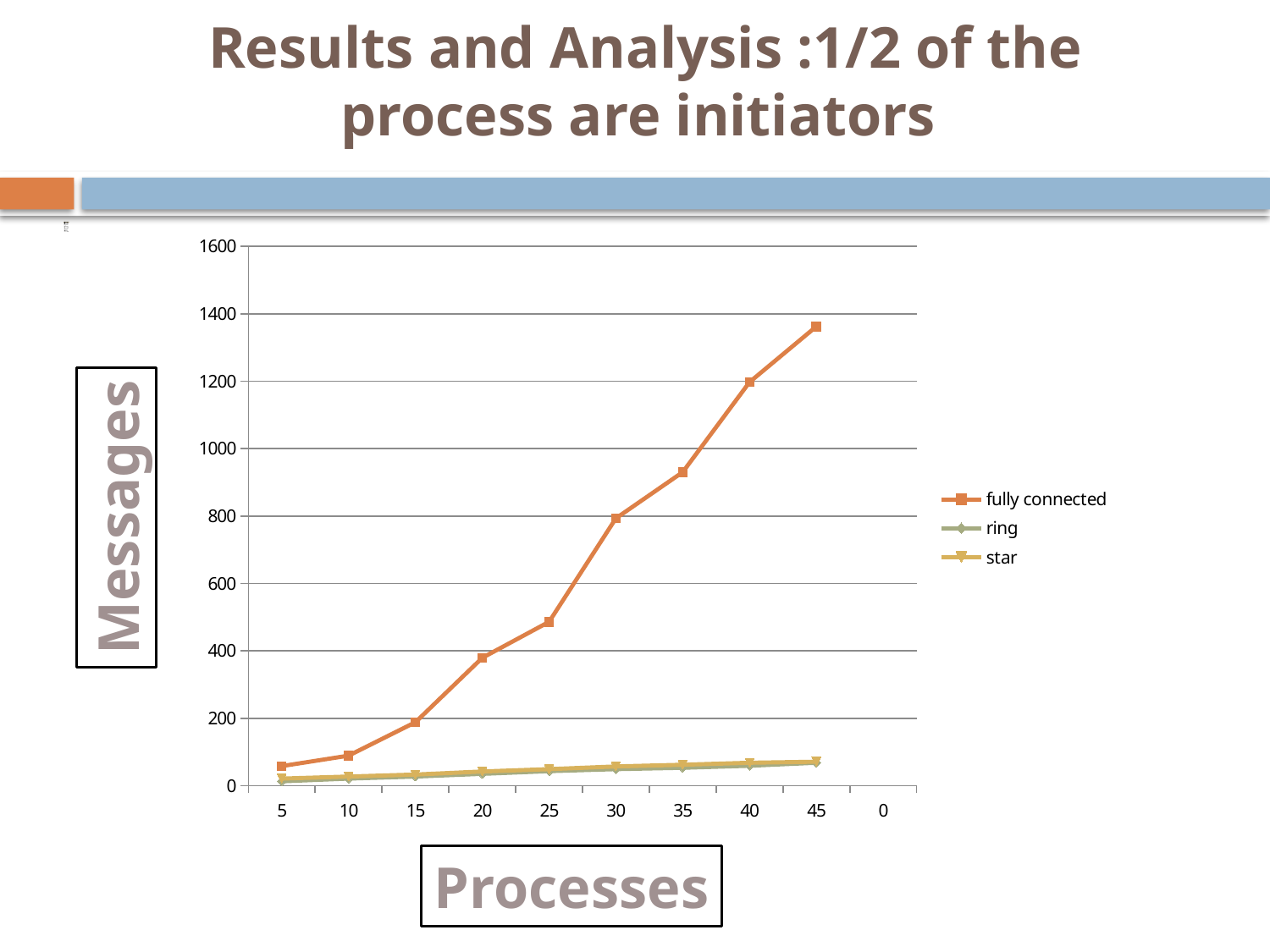
Is the value for ring at 45 processes greater or less than 200? less Is the value for fully connected at 45 processes greater or less than 1400? less Which is larger at 30 processes, the value for fully connected or the value for star? fully connected Is the value for fully connected at 25 processes greater or less than 600? less How many series does the legend list? 3 Which series has the highest number of messages at 45 processes? fully connected What kind of chart is shown on the slide? line chart What is the label on the vertical axis of the chart? Messages What is the label on the horizontal axis of the chart? Processes Do the values for the fully connected series rise or fall as the number of processes increases? rise